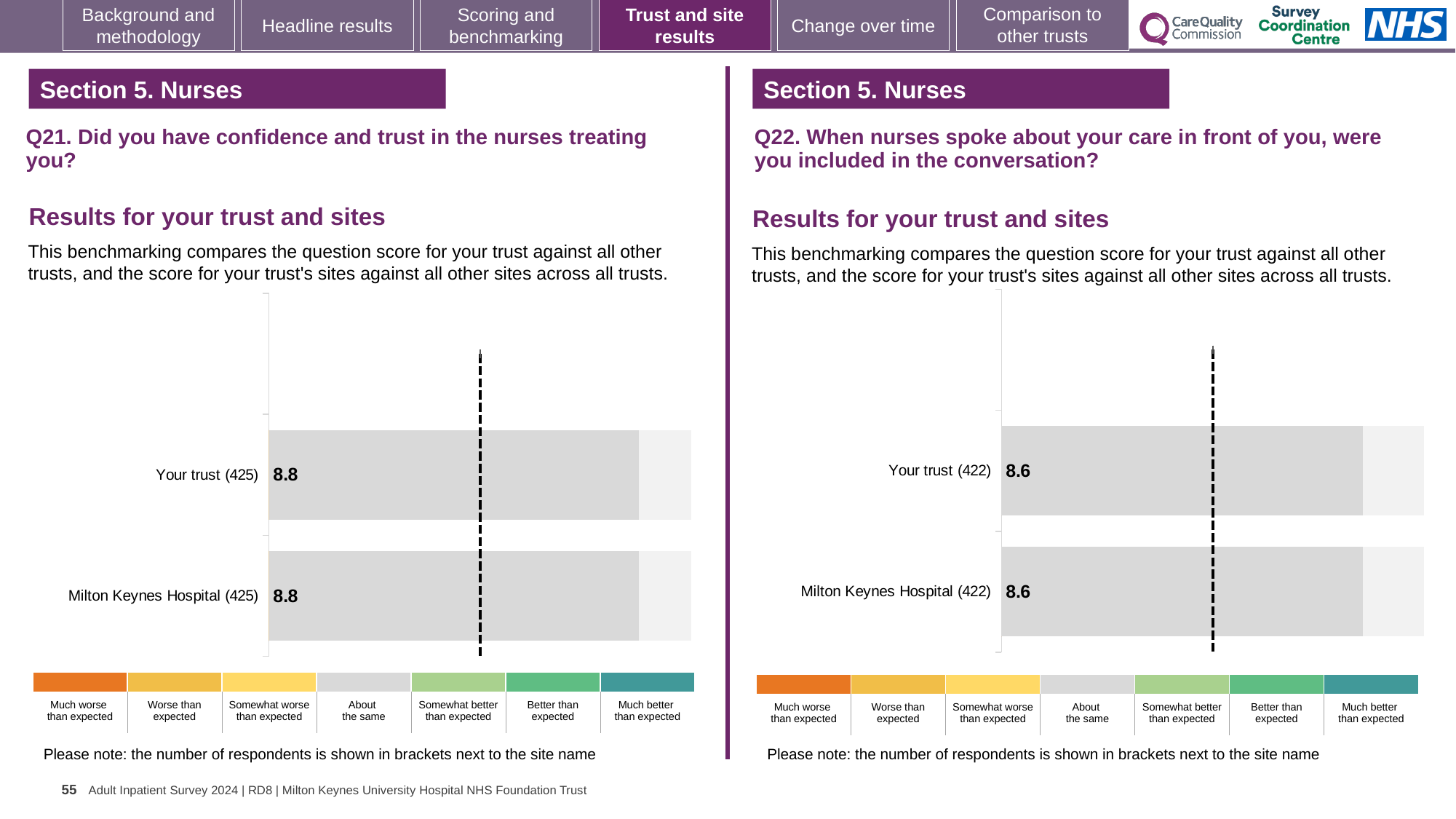
How many bars are plotted in the Q22 chart on the right? 2 Which is larger: the Your trust score in the Q21 chart on the left or the Your trust score in the Q22 chart on the right? Q21 chart on the left In the Q22 chart on the right, what is the score for Milton Keynes Hospital? 8.6 How many bars are plotted in the Q21 chart on the left? 2 In the Q22 chart on the right, how many respondents are shown in brackets next to Milton Keynes Hospital? 422 In the Q21 chart on the left, what is the score for Milton Keynes Hospital? 8.8 In the Q21 chart on the left, how many respondents are shown in brackets next to Your trust? 425 In the Q22 chart on the right, what is the difference between the score for Your trust and the score for Milton Keynes Hospital? 0 What kind of chart is the Q22 chart on the right? Bar chart In the Q21 chart on the left, what is the score for Your trust? 8.8 In the Q22 chart on the right, what is the score for Your trust? 8.6 In the Q21 chart on the left, what is the difference between the score for Your trust and the score for Milton Keynes Hospital? 0